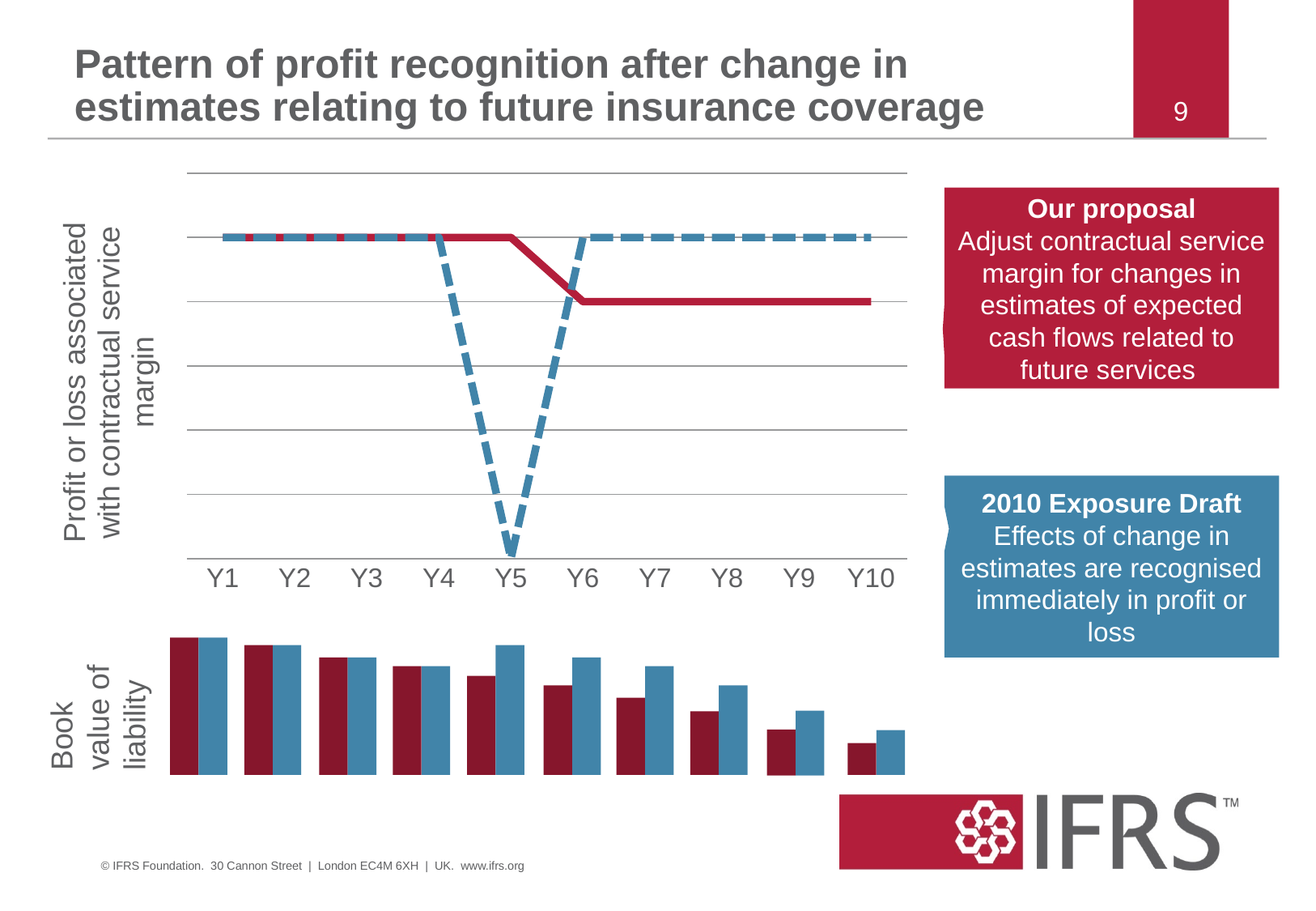
What kind of chart is the bottom chart on the slide? bar chart In the top line chart, which series is higher at Y8, the red solid line or the blue dashed line? the blue dashed line In the bottom bar chart, do the bar heights generally rise or fall from left to right? fall In the top line chart, which series is higher at Y5, the red solid line or the blue dashed line? the red solid line How many series are plotted in the top line chart? 2 What is the y-axis label of the bottom bar chart? Book value of liability How many groups of bars are shown in the bottom bar chart? 10 In the bottom bar chart, which bar is taller in the rightmost group, the red bar or the blue bar? the blue bar In the top line chart, at which year does the blue dashed line reach its lowest point? Y5 How many categories are shown on the x axis of the top line chart? 10 In the top line chart, does the red solid line rise or fall between Y4 and Y6? fall What kind of chart is the top chart on the slide? line chart